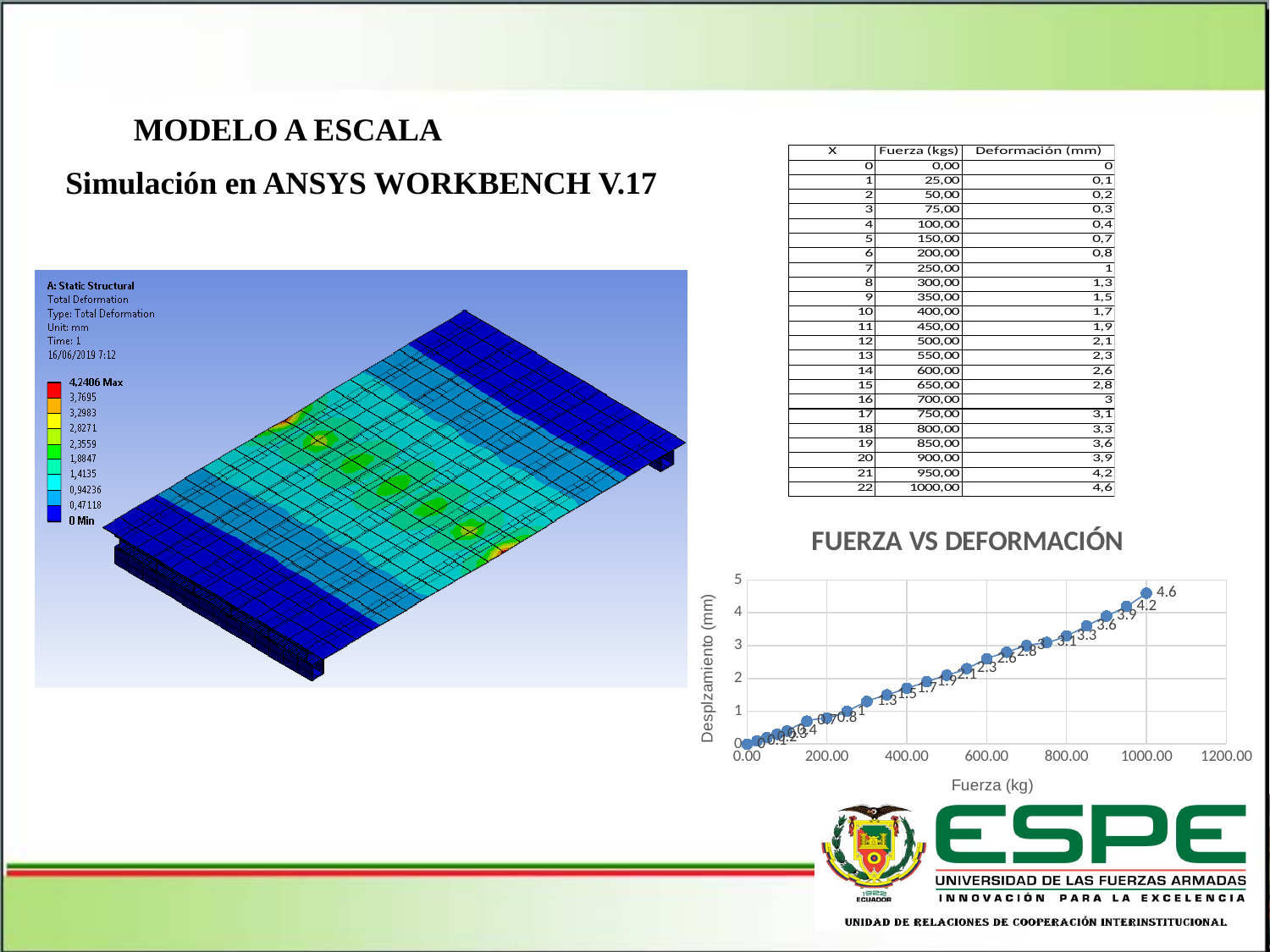
How many data points are plotted in the 'FUERZA VS DEFORMACIÓN' chart? 23 In the 'FUERZA VS DEFORMACIÓN' chart, what is the highest displacement value plotted? 4.6 What kind of chart is the 'FUERZA VS DEFORMACIÓN' chart? scatter chart In the 'FUERZA VS DEFORMACIÓN' chart, what is the lowest displacement value plotted? 0 In the 'FUERZA VS DEFORMACIÓN' chart, is the displacement at 600 kg greater or less than 2? greater In the 'FUERZA VS DEFORMACIÓN' chart, what is the displacement value at a force of 900 kg? 3.9 In the 'FUERZA VS DEFORMACIÓN' chart, which is larger: the displacement at 1000 kg or at 900 kg? 1000 kg What is the x-axis title of the 'FUERZA VS DEFORMACIÓN' chart? Fuerza (kg) In the 'FUERZA VS DEFORMACIÓN' chart, what is the displacement value at a force of 950 kg? 4.2 In the 'FUERZA VS DEFORMACIÓN' chart, do the displacement values rise or fall as force increases? rise In the 'FUERZA VS DEFORMACIÓN' chart, what is the displacement value at a force of 1000 kg? 4.6 In the 'FUERZA VS DEFORMACIÓN' chart, what is the difference between the displacement at 1000 kg and at 950 kg? 0.4